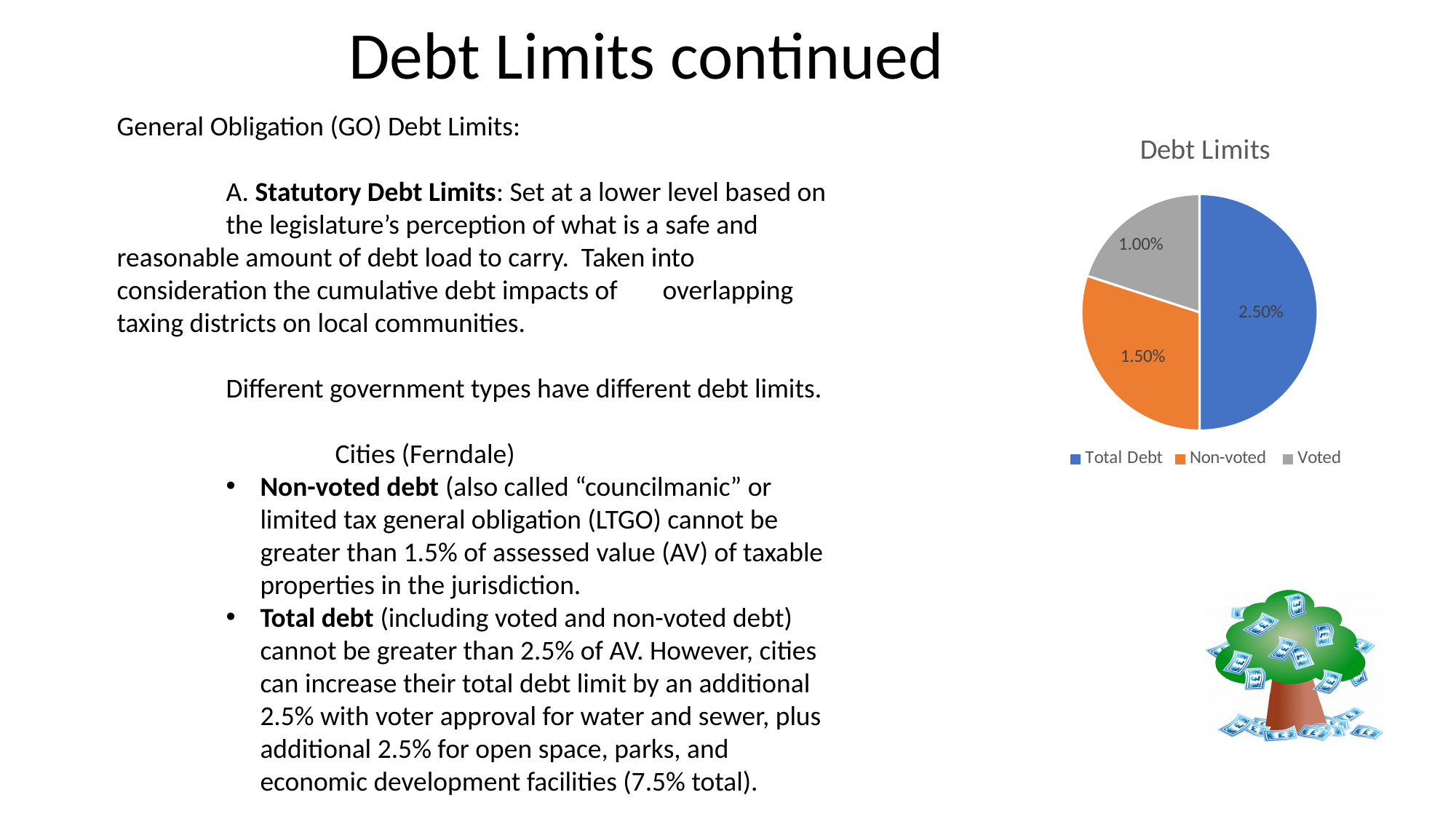
What colour is the Non-voted slice in the Debt Limits pie chart? Orange What is the difference between the Non-voted value and the Voted value in the Debt Limits chart? 0.50% What share of the Debt Limits pie does the Total Debt slice represent? 50% Which category has the smallest slice in the Debt Limits pie chart? Voted What type of chart is the Debt Limits chart? Pie chart What is the value shown for the Non-voted slice in the Debt Limits pie chart? 1.50% What is the difference between the Total Debt value and the Non-voted value in the Debt Limits chart? 1.00% In the Debt Limits chart, which is larger: the Non-voted value or the Voted value? Non-voted What is the value shown for the Voted slice in the Debt Limits pie chart? 1.00% How many slices does the Debt Limits pie chart have? 3 Which category has the largest slice in the Debt Limits pie chart? Total Debt What is the value shown for the Total Debt slice in the Debt Limits pie chart? 2.50%